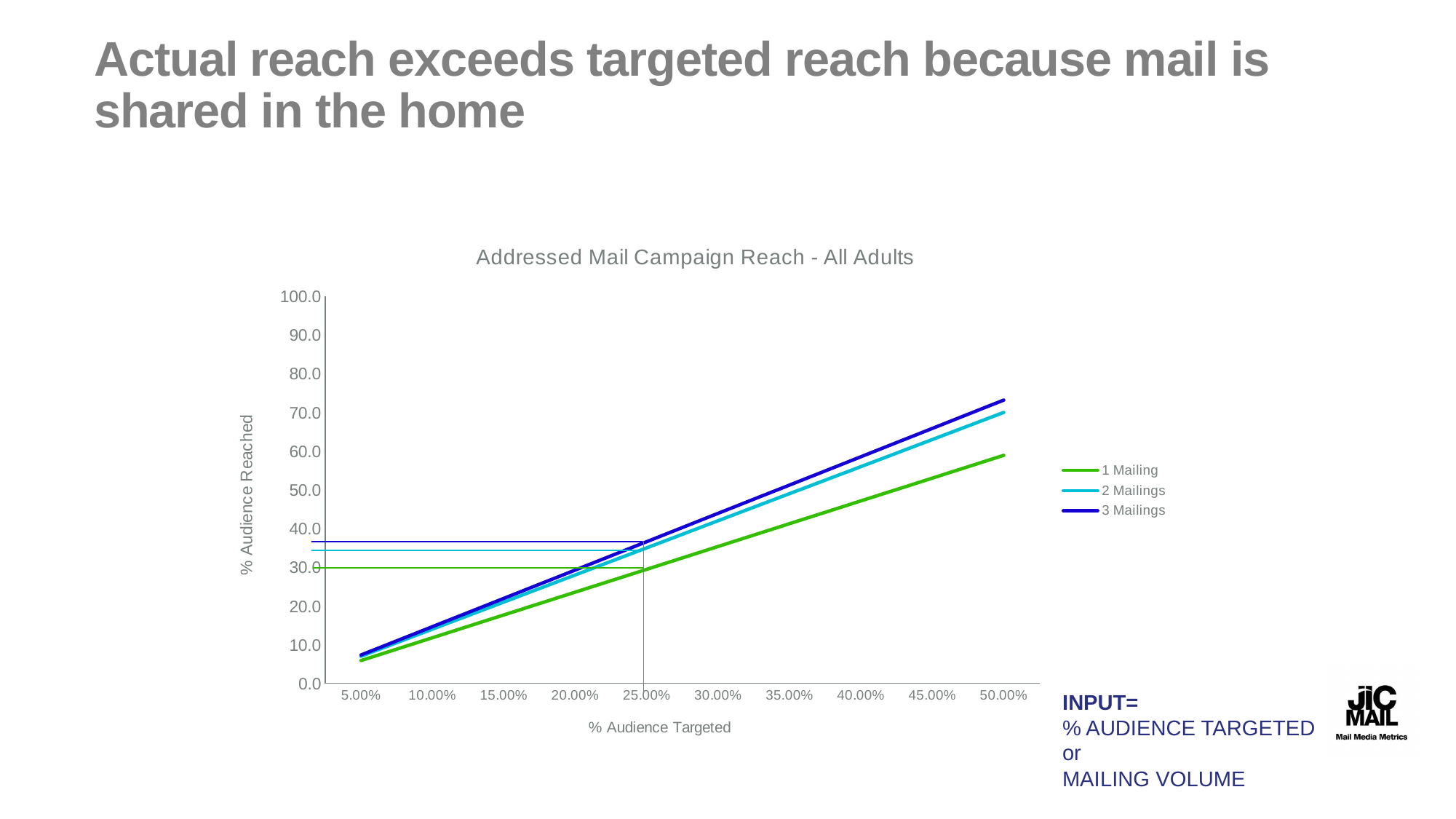
At 50.00% audience targeted, which is larger: the value for 1 Mailing or the value for 3 Mailings? 3 Mailings Is the value for 2 Mailings at 5.00% audience targeted greater or less than 10? less What is the title of the chart? Addressed Mail Campaign Reach - All Adults Is the value for 1 Mailing at 50.00% audience targeted greater or less than 50? greater Is the value for 3 Mailings at 25.00% audience targeted greater or less than 30? greater How many series does the legend list? 3 What kind of chart is shown on the slide? line chart Do the values for 1 Mailing rise or fall as % Audience Targeted increases? rise Which series has the lowest value at 50.00% audience targeted? 1 Mailing Which series has the highest value at 50.00% audience targeted? 3 Mailings How many tick labels are shown on the x axis? 10 What is the label of the y axis? % Audience Reached